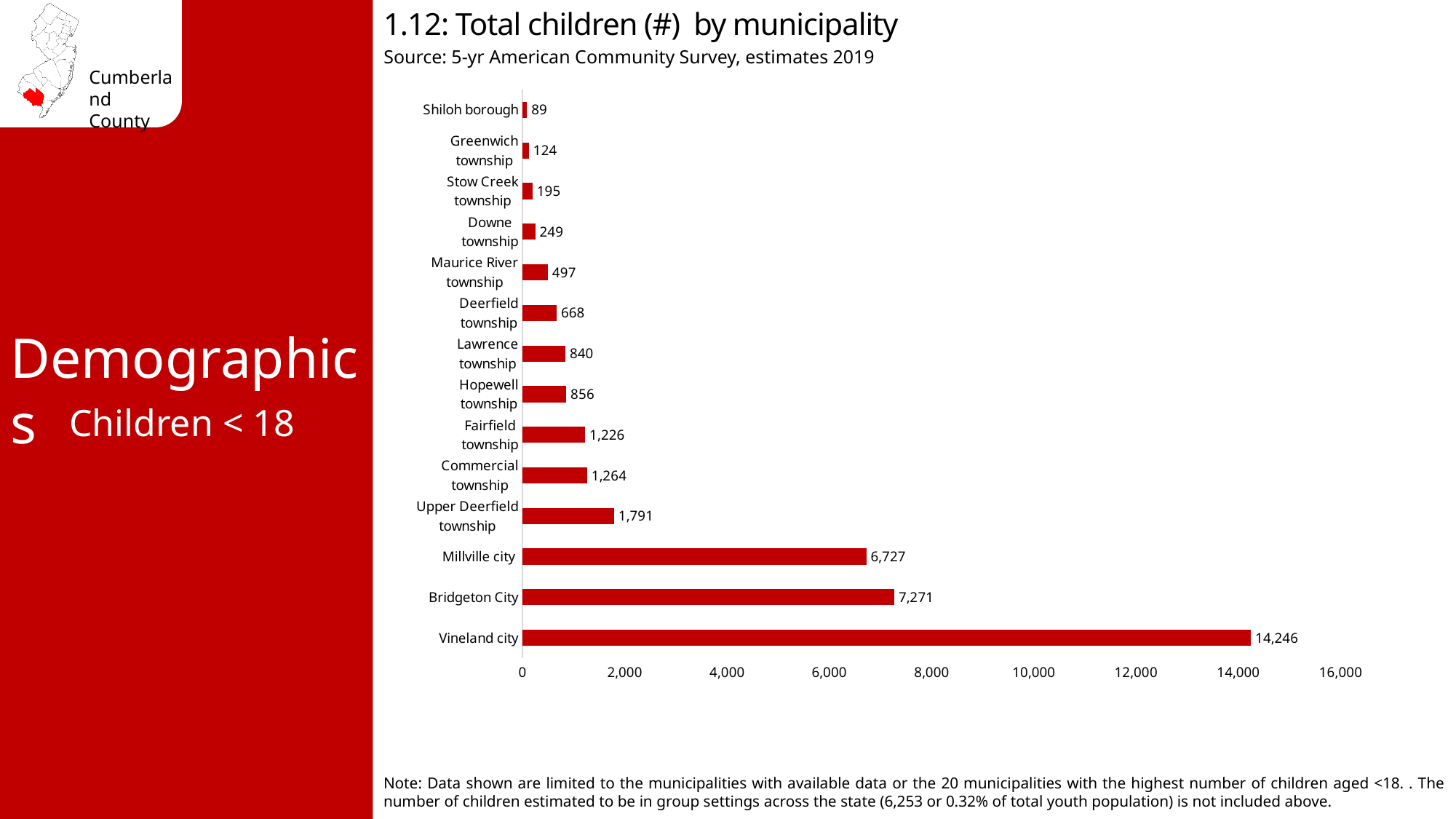
What is the total number of children in Shiloh borough? 89 How many municipalities are shown in the chart? 14 Which has more children, Fairfield township or Commercial township? Commercial township What is the difference in the number of children between Bridgeton City and Millville city? 544 Is the value for Bridgeton City greater or less than 8,000? less What is the source of the data shown in the chart? 5-yr American Community Survey, estimates 2019 Which municipality has the lowest number of children? Shiloh borough What is the total number of children in Vineland city? 14,246 What is the total number of children in Upper Deerfield township? 1,791 What is the total number of children in Millville city? 6,727 What kind of chart is shown on the slide? bar chart Which municipality has the highest number of children? Vineland city